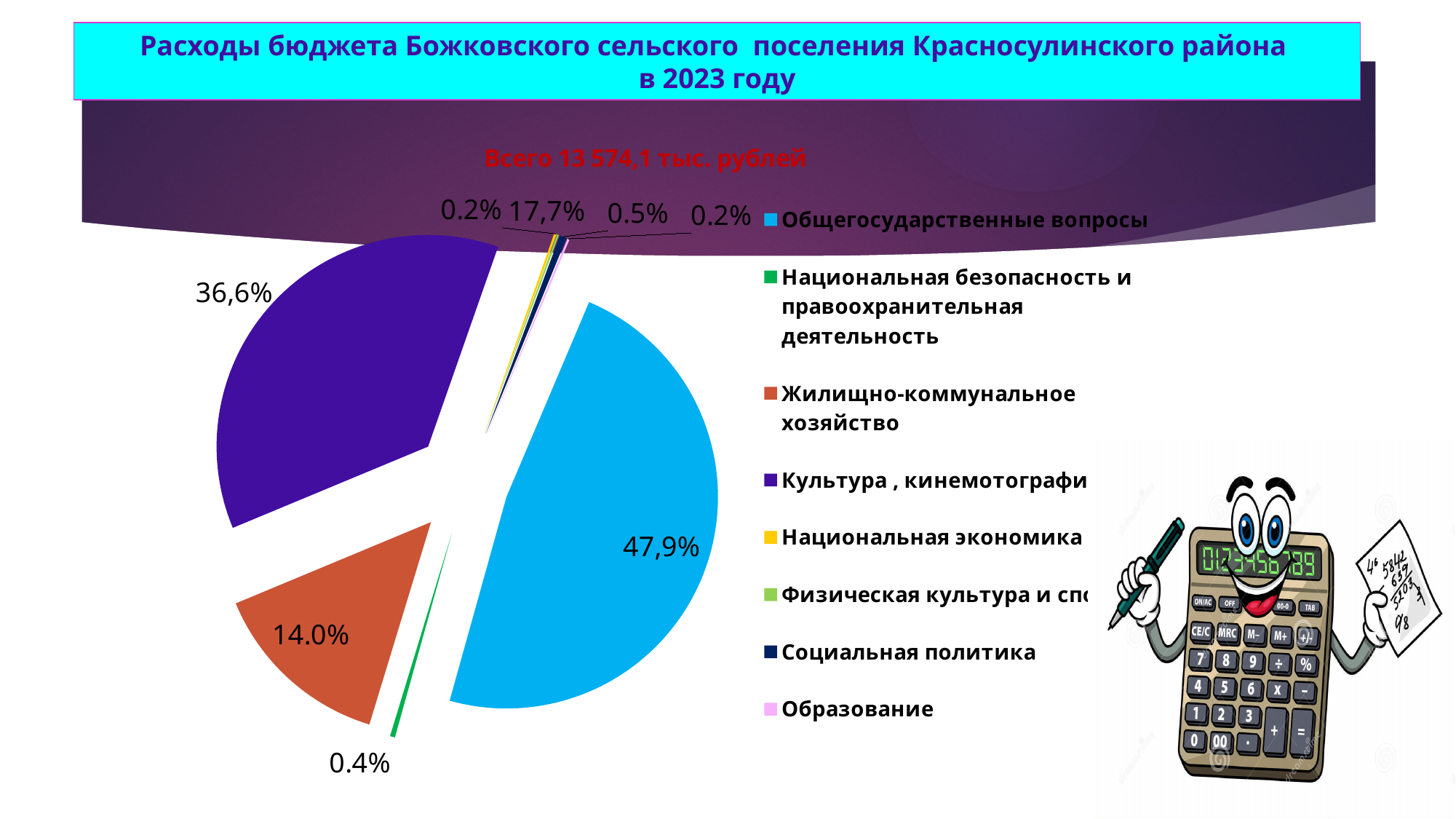
What total amount of expenditure is stated above the pie chart? 13 574,1 тыс. рублей Which year do the budget expenditures in the chart title refer to? 2023 What percentage is shown for Национальная безопасность и правоохранительная деятельность? 0.4% What percentage is shown for Культура, кинемотографи? 36,6% How many categories are listed in the legend of the pie chart? 8 What kind of chart is shown on the slide? pie chart Which is larger: the share for Жилищно-коммунальное хозяйство or the share for Национальная безопасность и правоохранительная деятельность? Жилищно-коммунальное хозяйство What percentage is shown for Жилищно-коммунальное хозяйство? 14.0% What is the difference in percentage points between the share for Общегосударственные вопросы and the share for Культура, кинемотографи? 11,3% Which category has the largest slice of the pie? Общегосударственные вопросы What share of the budget expenditure goes to Общегосударственные вопросы? 47,9% Which is larger: the share for Культура, кинемотографи or the share for Жилищно-коммунальное хозяйство? Культура, кинемотографи